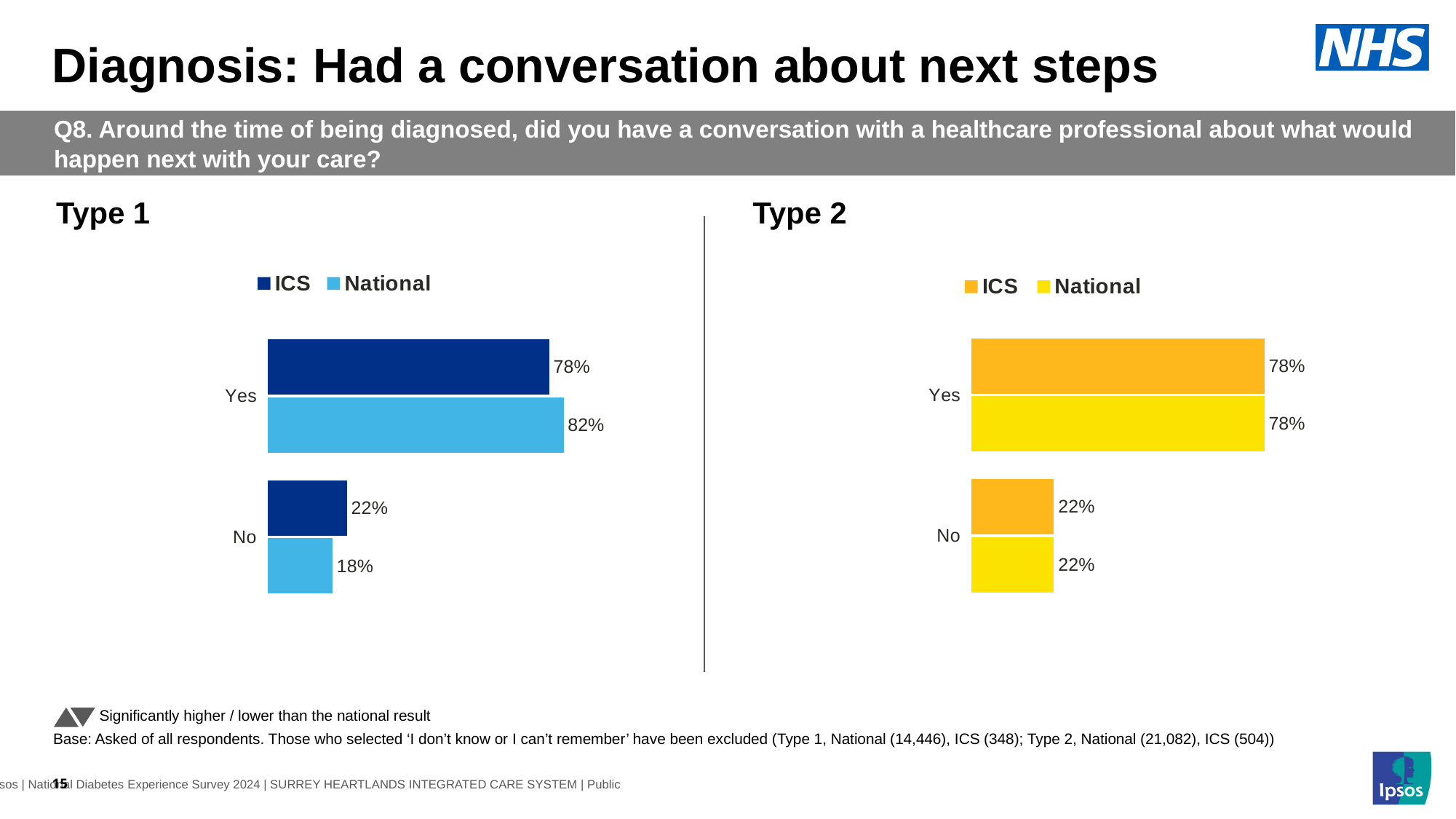
In the Type 2 chart, what is the National value for Yes? 78% What type of chart is used for Type 2? Bar chart In the Type 2 chart, what colour represents the National series? Yellow In the Type 1 chart, which series has the highest value for Yes? National In the Type 1 chart, what is the difference between the National and ICS values for Yes? 4 percentage points In the Type 2 chart, how many series does the legend list? 2 In the Type 1 chart, what is the National value for Yes? 82% In the Type 1 chart, which is larger for No: ICS or National? ICS In the Type 2 chart, what is the ICS value for No? 22% How many response categories are shown in the Type 1 chart? 2 In the Type 1 chart, what is the ICS value for Yes? 78% In the Type 1 chart, what is the National value for No? 18%